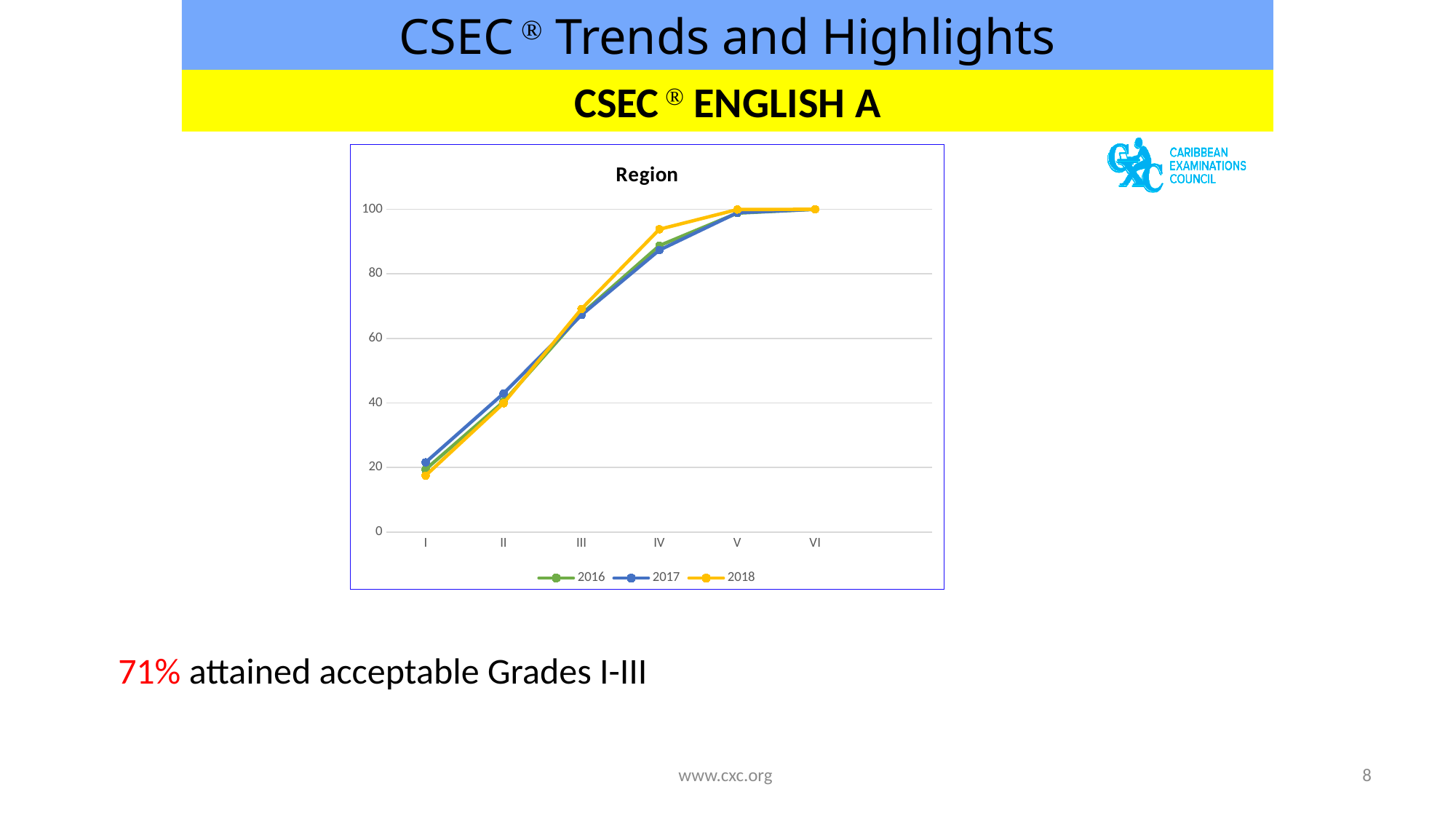
Which years are listed in the chart legend? 2016, 2017, 2018 What is the value for 2018 at category VI? 100 What is the title of the chart? Region At category IV, which series has the higher value, 2017 or 2018? 2018 Which category has the lowest values for all three series? I Is the value for 2017 at category III greater or less than 60? greater Is the value for 2018 at category IV greater or less than 80? greater How many categories are shown on the x axis? 6 Is the value for 2018 at category I greater or less than 20? less How many series does the legend list? 3 Do the values rise or fall from category I to category VI? rise What kind of chart is shown on the slide? line chart